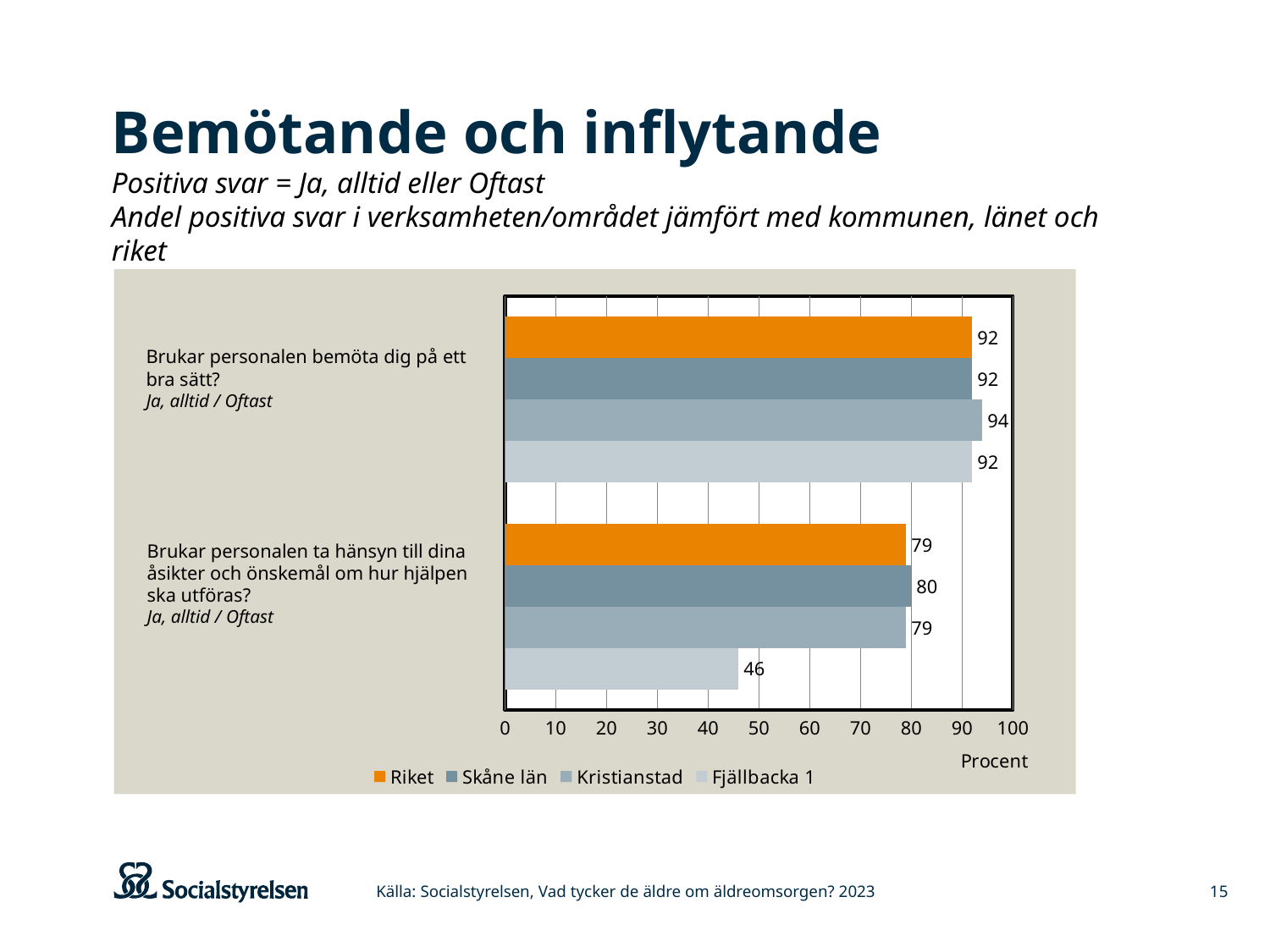
How many series does the legend list? 4 Is the value for Fjällbacka 1 for the question 'Brukar personalen ta hänsyn till dina åsikter och önskemål om hur hjälpen ska utföras?' greater or less than 50? less What unit is shown on the x axis of the chart? Procent How many questions (categories) are plotted in the chart? 2 Which series has the highest value for the question 'Brukar personalen bemöta dig på ett bra sätt?' Kristianstad What is the value for Kristianstad for the question 'Brukar personalen bemöta dig på ett bra sätt?' 94 What is the difference between the Riket value and the Fjällbacka 1 value for the question 'Brukar personalen ta hänsyn till dina åsikter och önskemål om hur hjälpen ska utföras?' 33 What kind of chart is shown on the slide? bar chart For Fjällbacka 1, which question has the larger value: 'Brukar personalen bemöta dig på ett bra sätt?' or 'Brukar personalen ta hänsyn till dina åsikter och önskemål om hur hjälpen ska utföras?' Brukar personalen bemöta dig på ett bra sätt? What is the value for Fjällbacka 1 for the question 'Brukar personalen ta hänsyn till dina åsikter och önskemål om hur hjälpen ska utföras?' 46 What is the value for Skåne län for the question 'Brukar personalen ta hänsyn till dina åsikter och önskemål om hur hjälpen ska utföras?' 80 Which series has the lowest value for the question 'Brukar personalen ta hänsyn till dina åsikter och önskemål om hur hjälpen ska utföras?' Fjällbacka 1